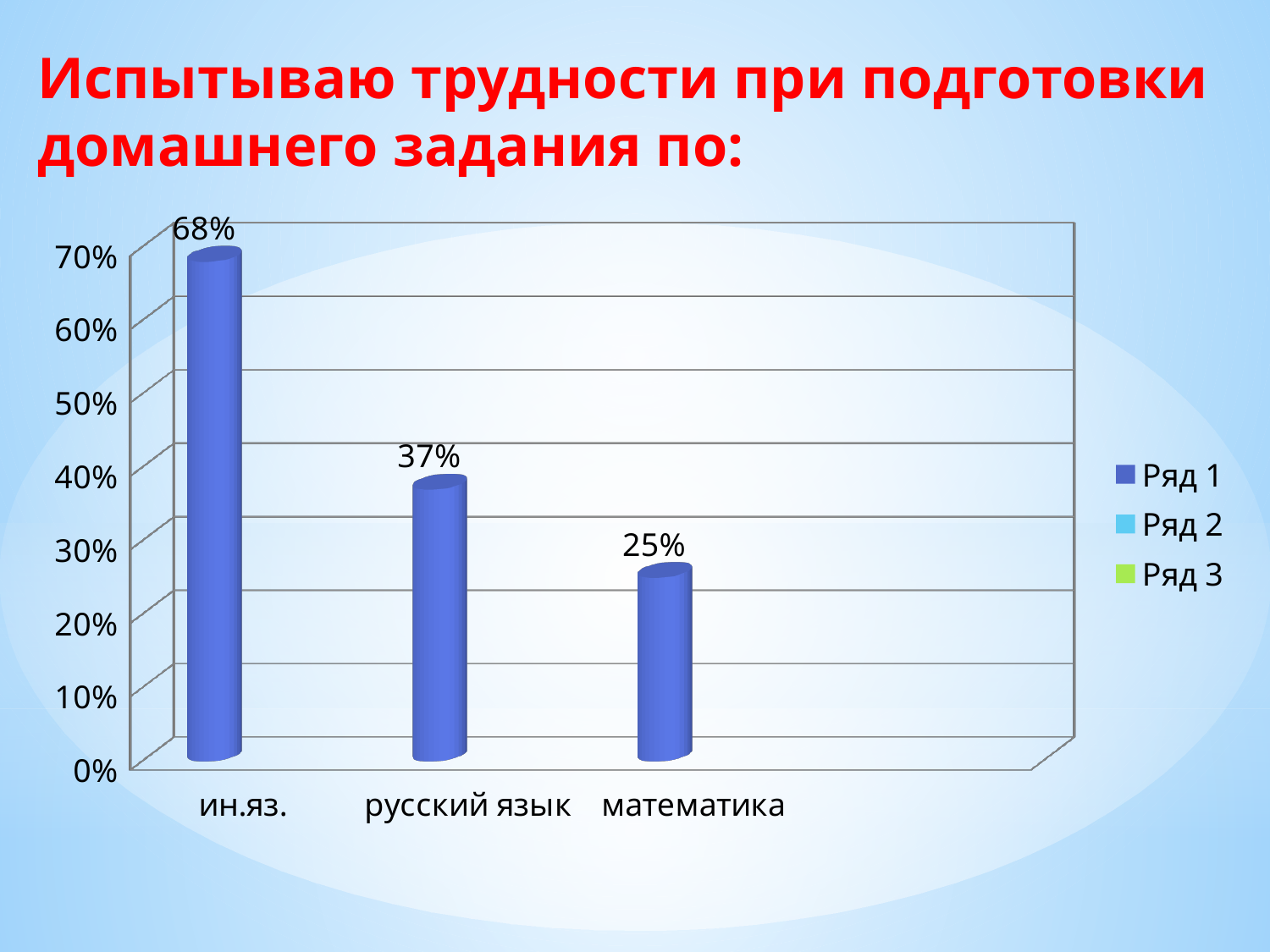
What is the value for ин.яз.? 68% What is the difference between the values for ин.яз. and русский язык? 31% Which category has the lowest value? математика Which is larger, the value for русский язык or the value for математика? русский язык What is the value for русский язык? 37% Do the values rise or fall from left to right along the x axis? fall How many categories are shown on the x axis? 3 What is the difference between the values for русский язык and математика? 12% What is the value for математика? 25% Which category has the highest value? ин.яз. What kind of chart is shown on the slide? bar chart How many series does the legend list? 3